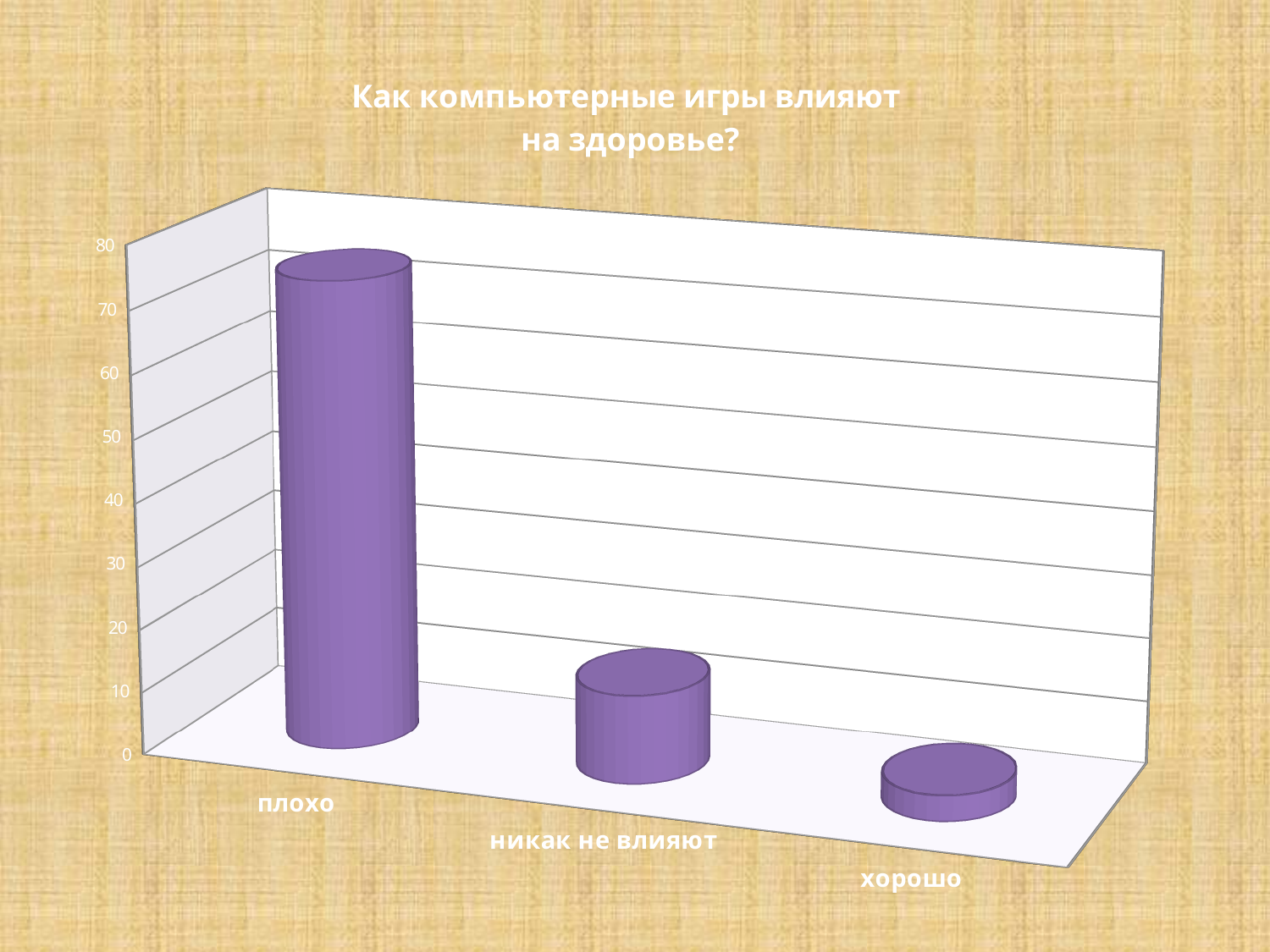
What is the title of the chart? Как компьютерные игры влияют на здоровье? Which is larger, the value for никак не влияют or the value for хорошо? никак не влияют How many categories are shown on the x axis? 3 Is the value for хорошо greater or less than 20? less Is the value for никак не влияют greater or less than 40? less Which is larger, the value for плохо or the value for никак не влияют? плохо What is the highest value shown on the vertical axis? 80 Is the value for плохо greater or less than 50? greater What kind of chart is shown on the slide? bar chart Which category has the lowest value? хорошо Which category has the highest value? плохо Do the values rise or fall from left to right along the x axis? fall